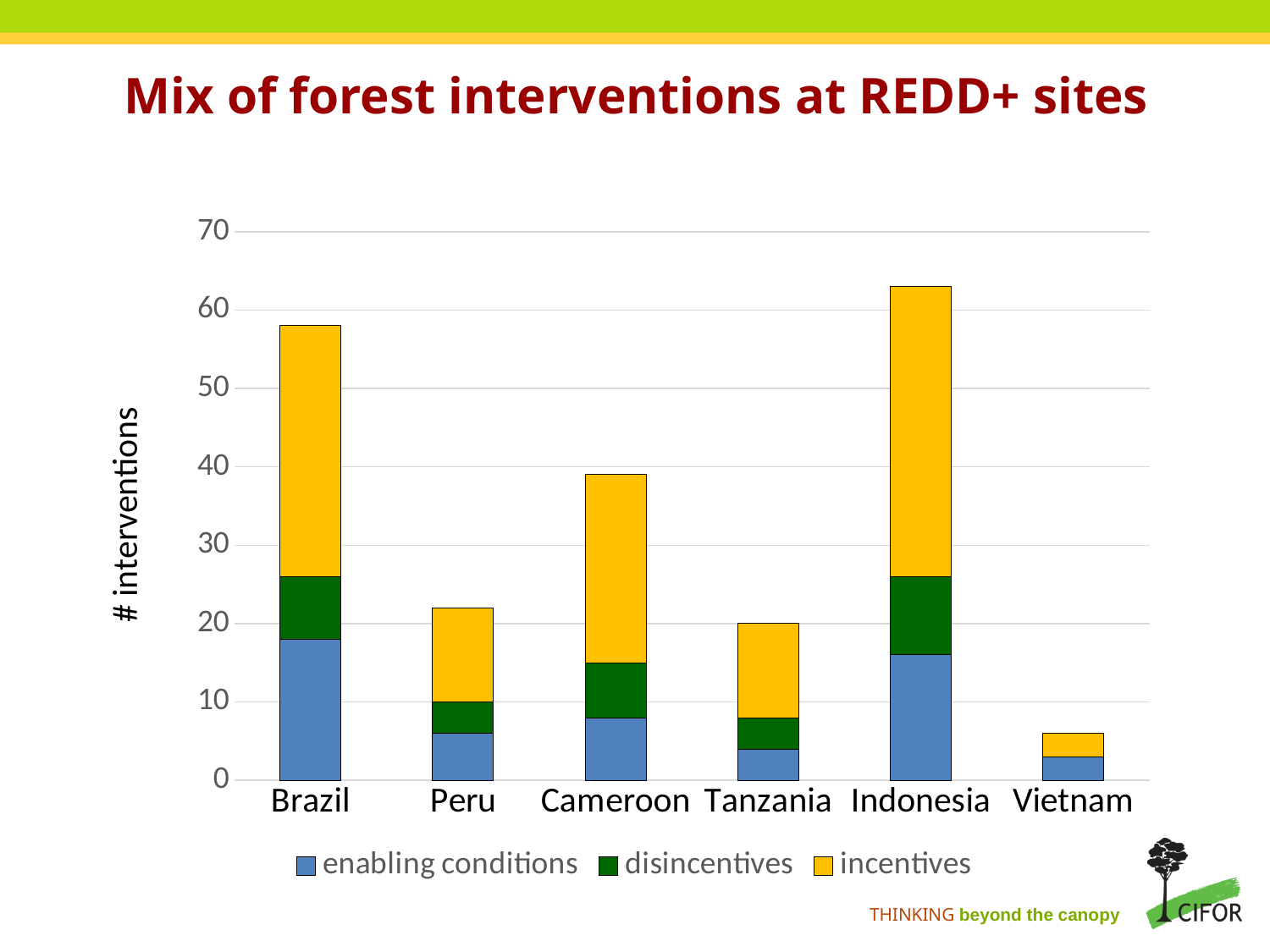
Which colour represents the 'incentives' series in the chart? yellow What kind of chart is shown on the slide? stacked bar chart What is the label on the y axis of the chart? # interventions Which has more total interventions, Brazil or Cameroon? Brazil Is the total number of interventions for Indonesia greater or less than 60? greater Is the total number of interventions for Vietnam greater or less than 10? less How many series does the legend list? 3 Which country has the shortest stacked bar (fewest interventions in total)? Vietnam How many countries are shown on the x axis of the chart? 6 Which country has the tallest stacked bar (most interventions in total)? Indonesia Is the total number of interventions for Brazil greater or less than 50? greater